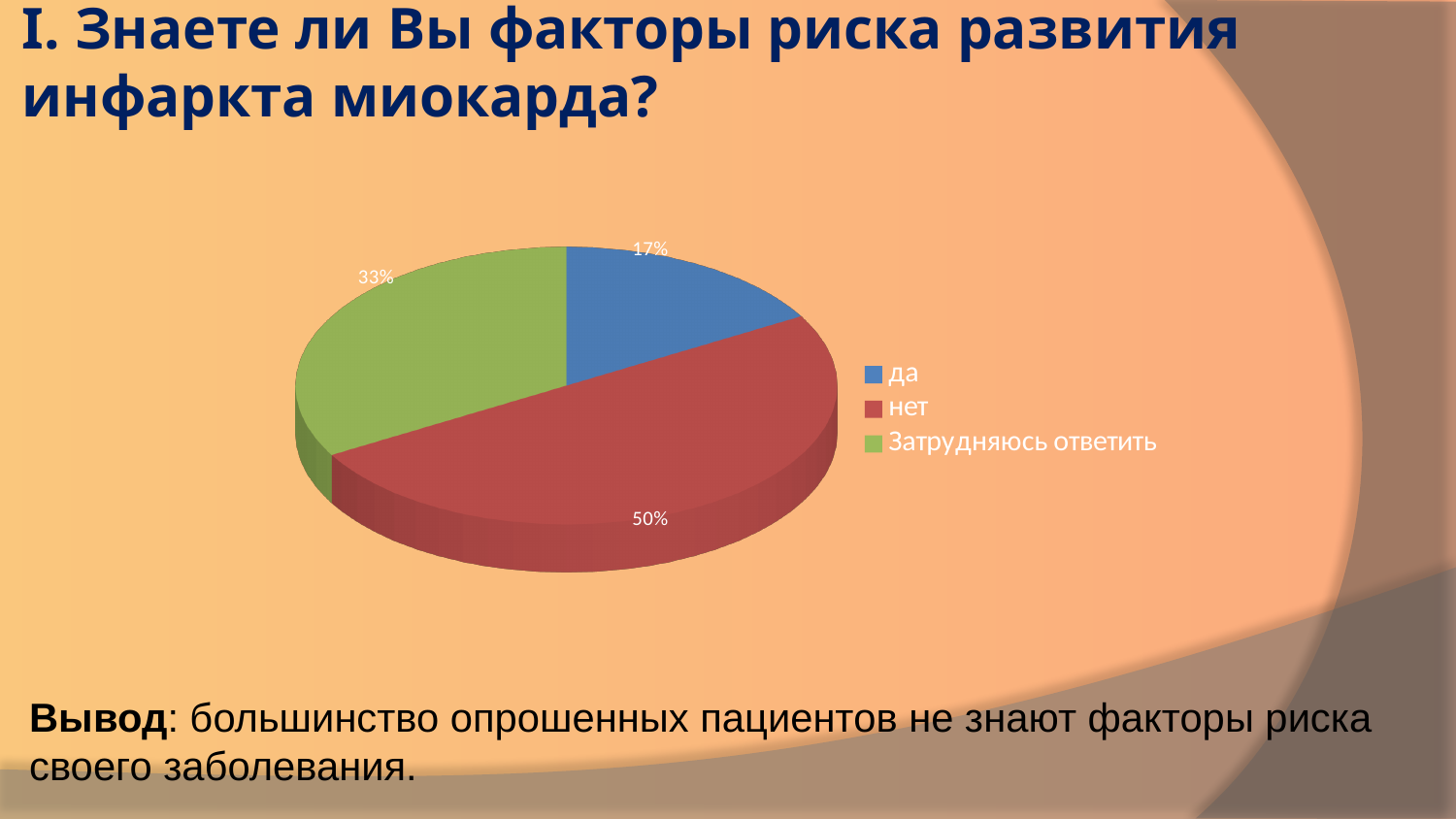
How many slices does the pie chart have? 3 What kind of chart is shown on the slide? pie chart What is the difference in percentage points between "нет" and "да"? 33 Which answer has the largest share of the pie? нет What percentage of respondents answered "нет"? 50% How many entries does the legend list? 3 Which answer has the smallest share of the pie? да What is the difference in percentage points between "Затрудняюсь ответить" and "да"? 16 What percentage of respondents answered "да"? 17% What colour is the slice for "Затрудняюсь ответить"? green Which is larger, the share for "нет" or the share for "Затрудняюсь ответить"? нет What percentage of respondents answered "Затрудняюсь ответить"? 33%